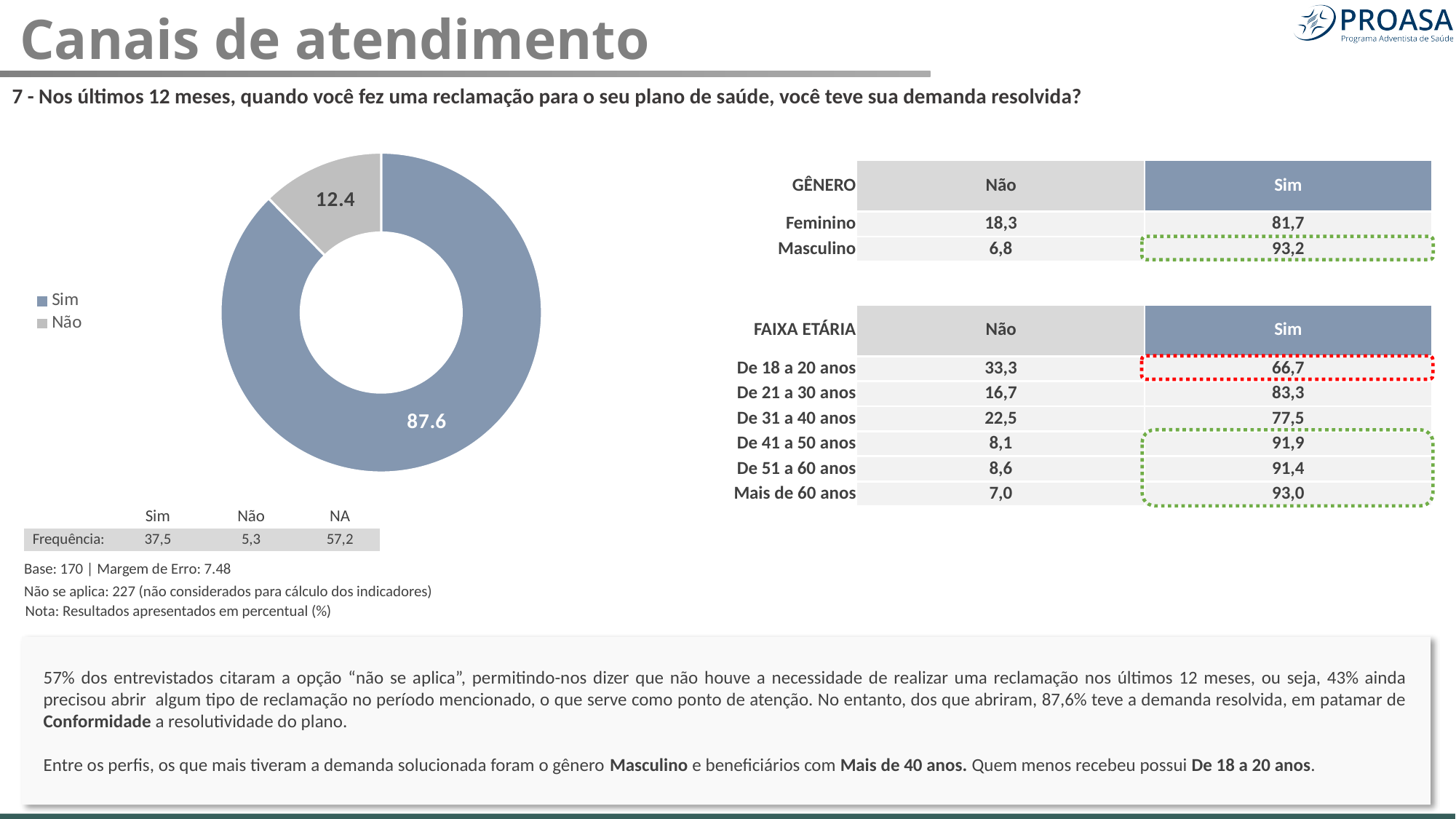
What kind of chart is shown on the left of the slide? Donut (pie) chart What value is shown for the Sim slice of the donut chart? 87.6 Which colour represents Não in the donut chart? Grey How many entries does the legend of the donut chart list? 2 Which colour represents Sim in the donut chart? Blue How many slices does the donut chart have? 2 What share of the donut chart does the Sim slice represent? 87.6 What is the difference between the Sim and Não values in the donut chart? 75.2 Which slice of the donut chart is the smallest? Não In the donut chart, is the value for Sim larger or smaller than the value for Não? larger What value is shown for the Não slice of the donut chart? 12.4 Which slice of the donut chart is the largest? Sim